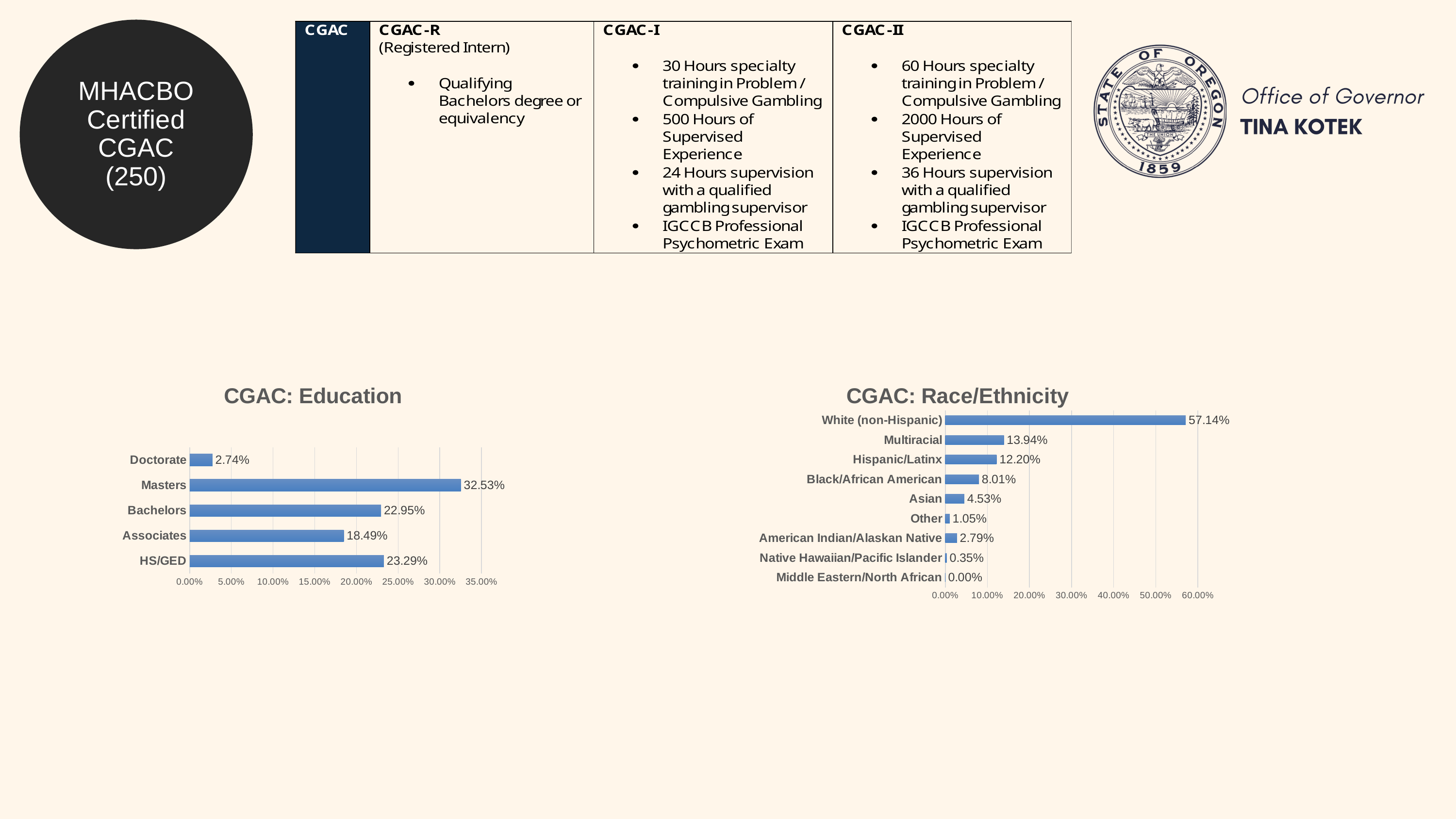
In the CGAC: Education chart, which category has the lowest value? Doctorate In the CGAC: Race/Ethnicity chart, what is the value for Hispanic/Latinx? 12.20% In the CGAC: Race/Ethnicity chart, what is the difference between White (non-Hispanic) and Multiracial? 43.20% How many categories are shown in the CGAC: Education chart? 5 In the CGAC: Race/Ethnicity chart, which is larger, Asian or Black/African American? Black/African American In the CGAC: Race/Ethnicity chart, what is the value for Middle Eastern/North African? 0.00% How many categories are shown in the CGAC: Race/Ethnicity chart? 9 What kind of chart is the CGAC: Education chart? Bar chart In the CGAC: Education chart, what is the value for Masters? 32.53% In the CGAC: Education chart, which is larger, HS/GED or Bachelors? HS/GED In the CGAC: Education chart, what is the difference between Bachelors and Associates? 4.46% In the CGAC: Race/Ethnicity chart, which category has the highest value? White (non-Hispanic)